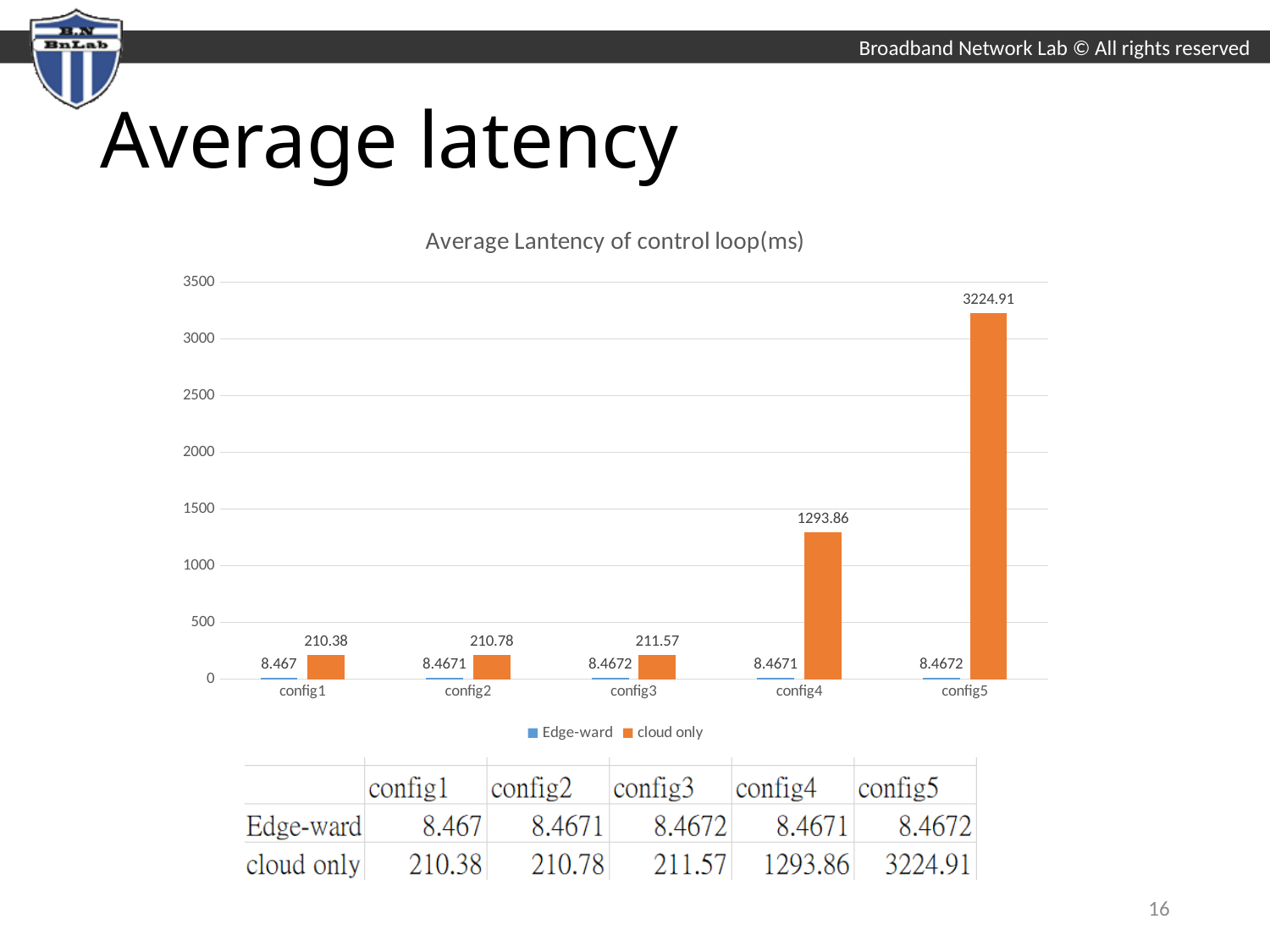
What is the cloud only value for config5? 3224.91 How many series does the legend list? 2 What is the cloud only value for config4? 1293.86 Which is larger, the cloud only value for config3 or for config2? config3 What kind of chart is shown? bar chart What is the Edge-ward value for config1? 8.467 Which config has the lowest cloud only value? config1 Is the cloud only value for config4 greater or less than 1000? greater Which config has the highest cloud only value? config5 What is the difference between the cloud only values for config5 and config4? 1931.05 What is the title of the chart? Average Lantency of control loop(ms) How many configs are shown on the x axis? 5